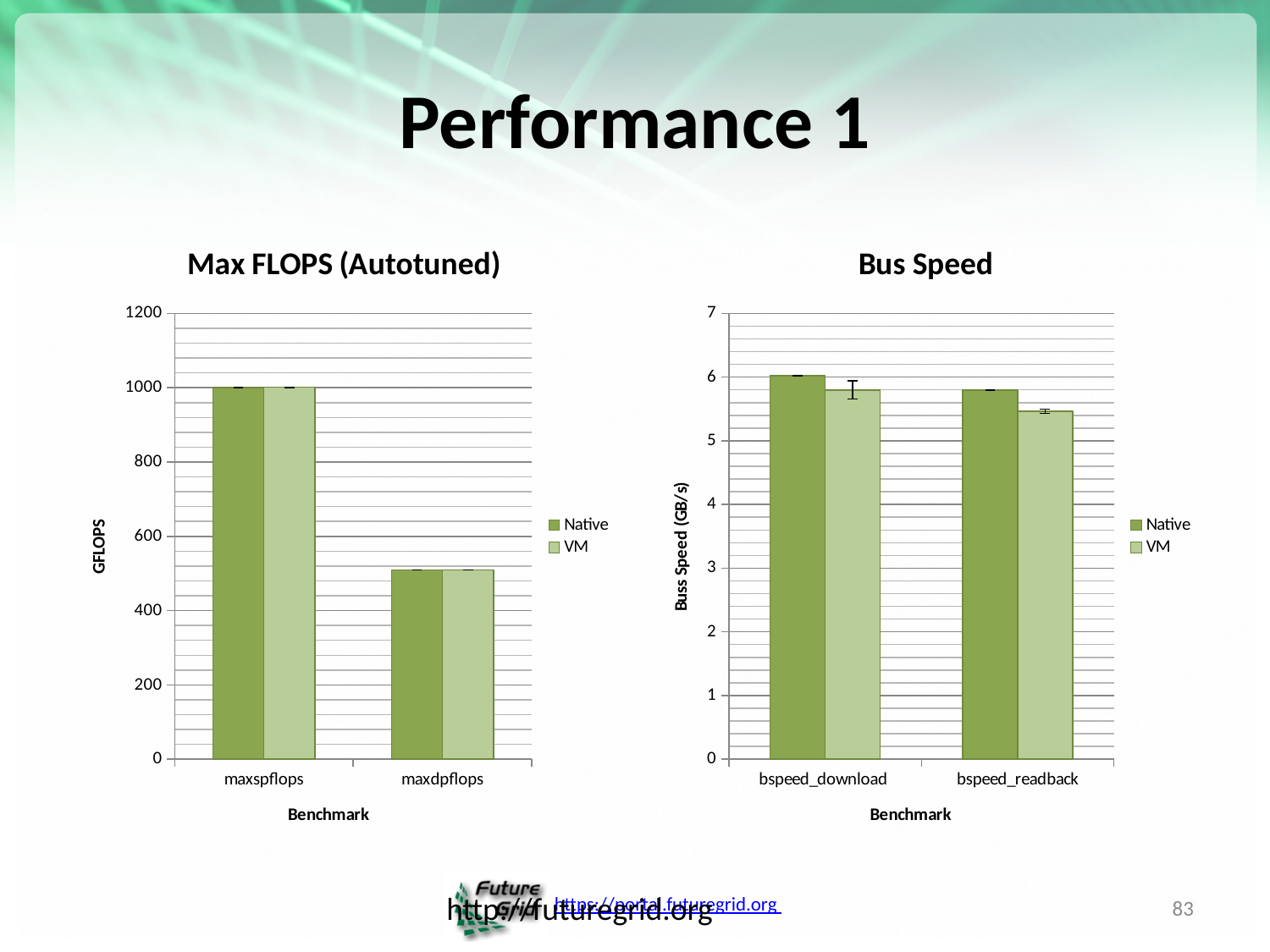
What kind of chart is the Max FLOPS (Autotuned) chart? bar chart In the Bus Speed chart, is the VM value for bspeed_readback greater or less than 6? less In the Max FLOPS (Autotuned) chart, is the VM value for maxdpflops greater or less than 600? less How many benchmark categories are shown on the x axis of the Bus Speed chart? 2 In the Max FLOPS (Autotuned) chart, do the values rise or fall from maxspflops to maxdpflops? fall In the Bus Speed chart, is the Native value for bspeed_download greater or less than 5? greater In the Bus Speed chart, which is larger: the Native value for bspeed_download or the VM value for bspeed_readback? Native value for bspeed_download What is the y-axis label of the Bus Speed chart? Buss Speed (GB/s) How many series does the legend of the Max FLOPS (Autotuned) chart list? 2 In the Bus Speed chart, which bar is the lowest? VM for bspeed_readback In the Max FLOPS (Autotuned) chart, which benchmark has the larger Native value, maxspflops or maxdpflops? maxspflops